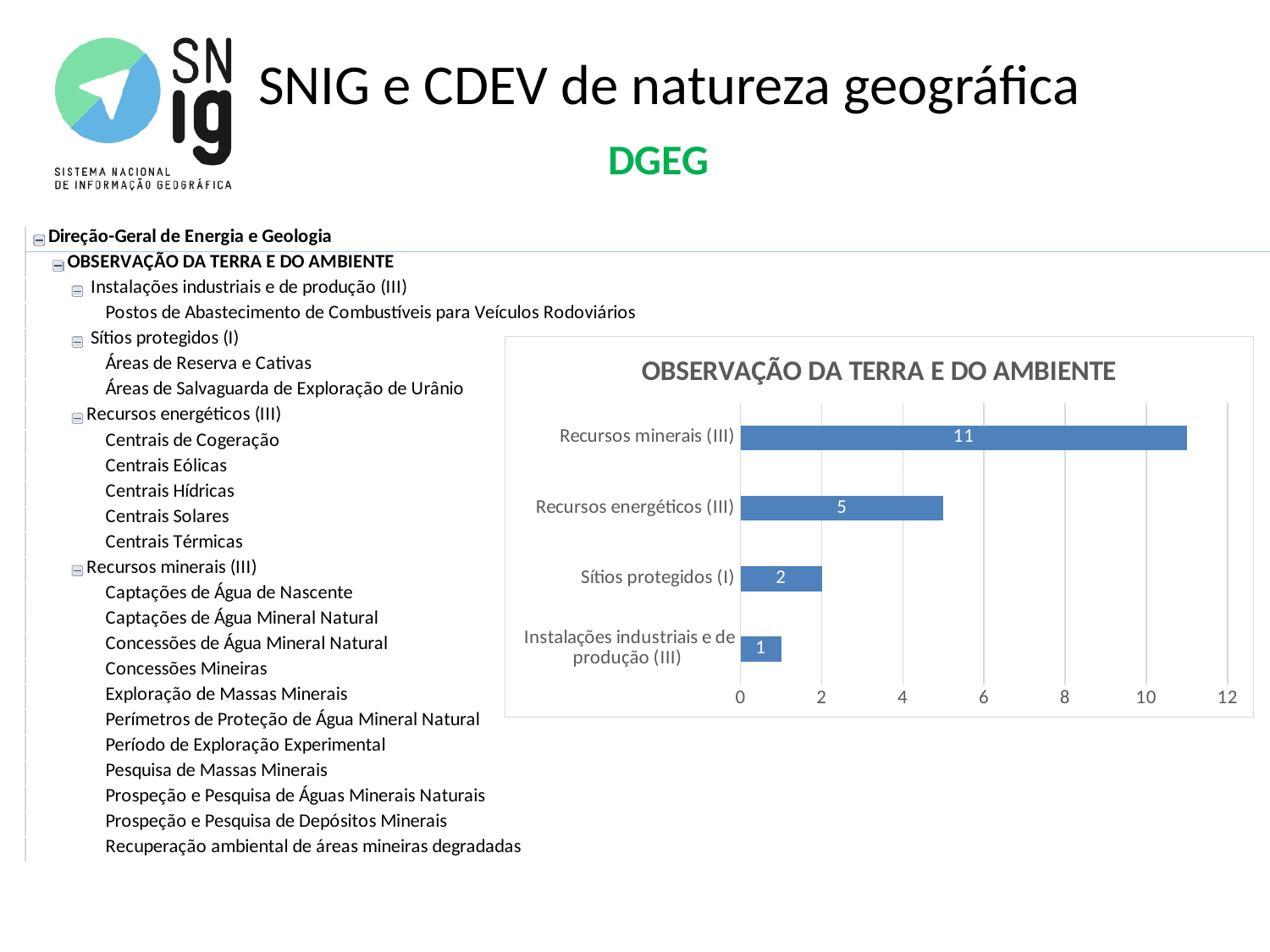
How many categories are shown in the chart? 4 What is the value for Recursos energéticos (III)? 5 What is the value for Sítios protegidos (I)? 2 Which category has the highest value? Recursos minerais (III) What is the difference between the values for Recursos minerais (III) and Recursos energéticos (III)? 6 What is the value for Recursos minerais (III)? 11 What is the value for Instalações industriais e de produção (III)? 1 What is the title of the chart? OBSERVAÇÃO DA TERRA E DO AMBIENTE Which is larger, the value for Sítios protegidos (I) or the value for Recursos energéticos (III)? Recursos energéticos (III) Which category has the lowest value? Instalações industriais e de produção (III) What kind of chart is shown on the slide? bar chart Is the value for Recursos minerais (III) greater or less than 10? greater